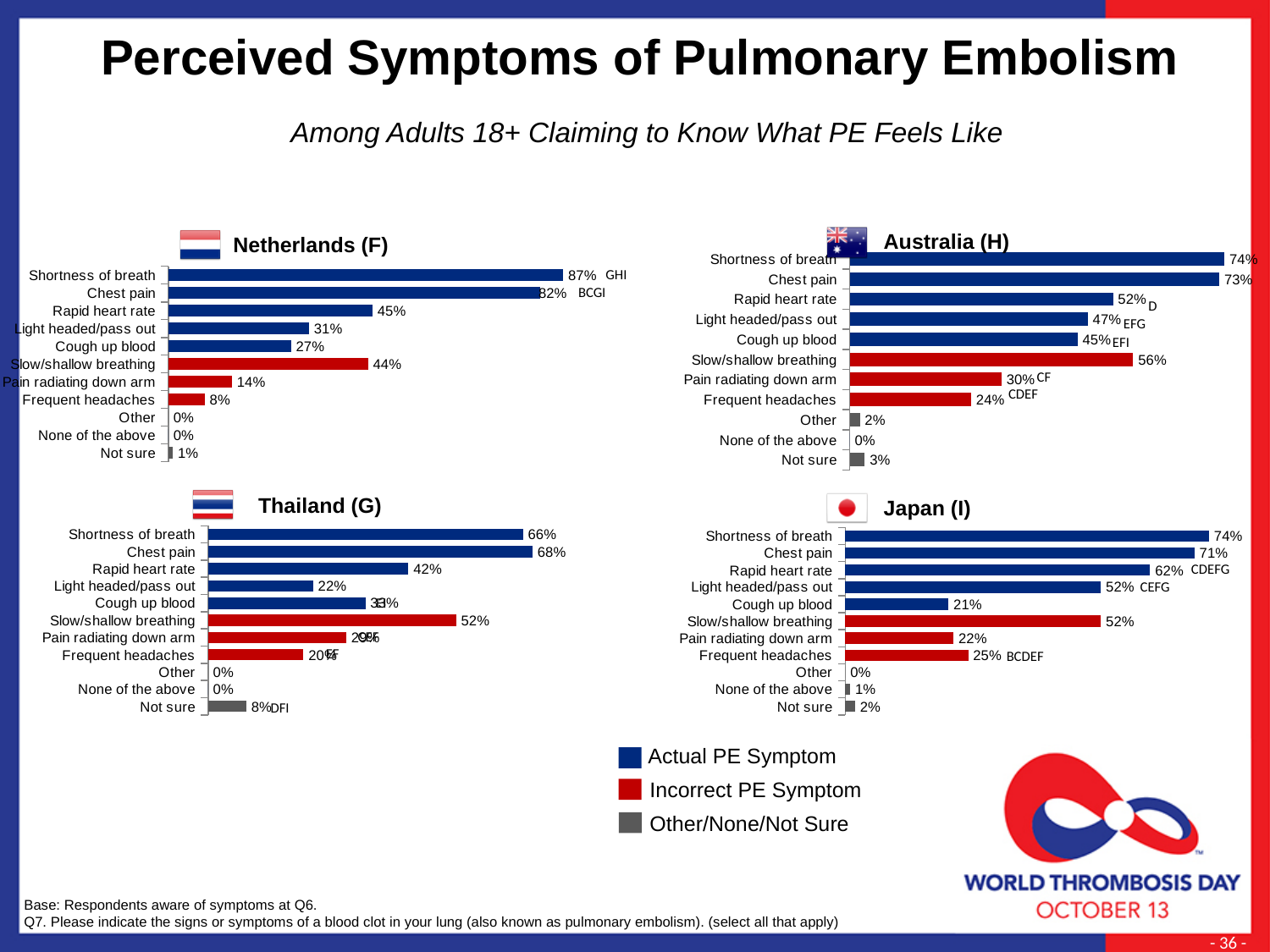
In the Australia (H) chart, what is the difference between Shortness of breath and Frequent headaches? 50% What type of chart is used for Japan (I)? Bar chart In the Thailand (G) chart, which is larger: Chest pain or Shortness of breath? Chest pain In the Australia (H) chart, which symptom has the highest percentage? Shortness of breath In the Japan (I) chart, what percentage is shown for Rapid heart rate? 62% In the Netherlands (F) chart, what percentage is shown for Shortness of breath? 87% In the Japan (I) chart, what is the difference between Chest pain and Cough up blood? 50% In the Netherlands (F) chart, which is larger: Rapid heart rate or Slow/shallow breathing? Rapid heart rate In the Netherlands (F) chart, what percentage is shown for Slow/shallow breathing? 44% How many entries does the shared legend list? 3 How many symptom categories are listed in the Australia (H) chart? 11 In the Thailand (G) chart, what percentage is shown for Not sure? 8%